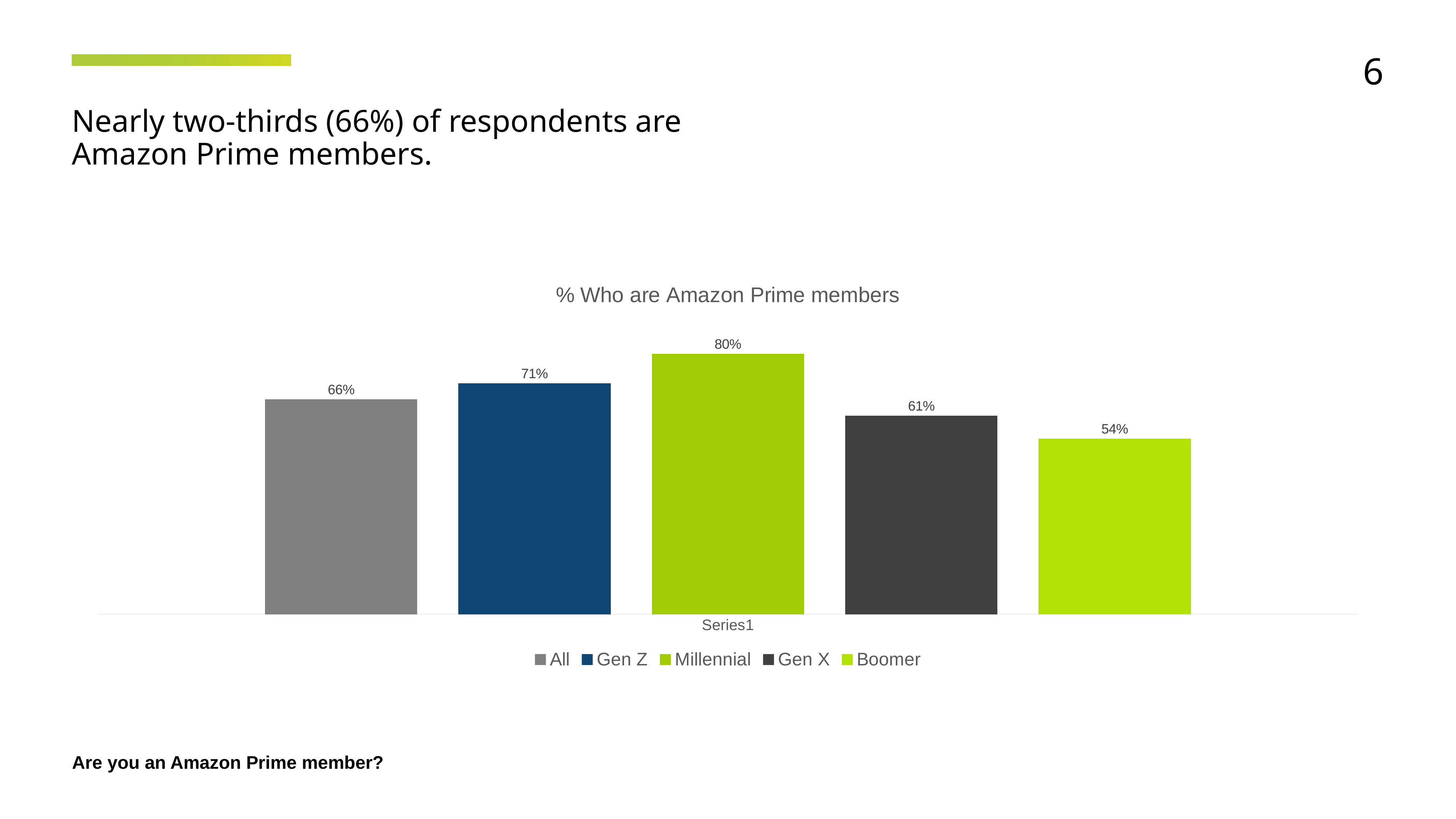
What is the value shown for Gen X? 61% What is the title of the chart? % Who are Amazon Prime members What is the value shown for Gen Z? 71% Which group has the lowest share of Amazon Prime members? Boomer What kind of chart is shown on the slide? Bar chart What is the difference between the Gen Z and Gen X values? 10% What percentage of Millennial respondents are Amazon Prime members? 80% What is the value shown for Boomer? 54% Which group has the highest share of Amazon Prime members? Millennial Which is larger, the value for Gen Z or the value for All? Gen Z What is the difference between the Millennial and Boomer values? 26% How many bars are shown in the chart? 5